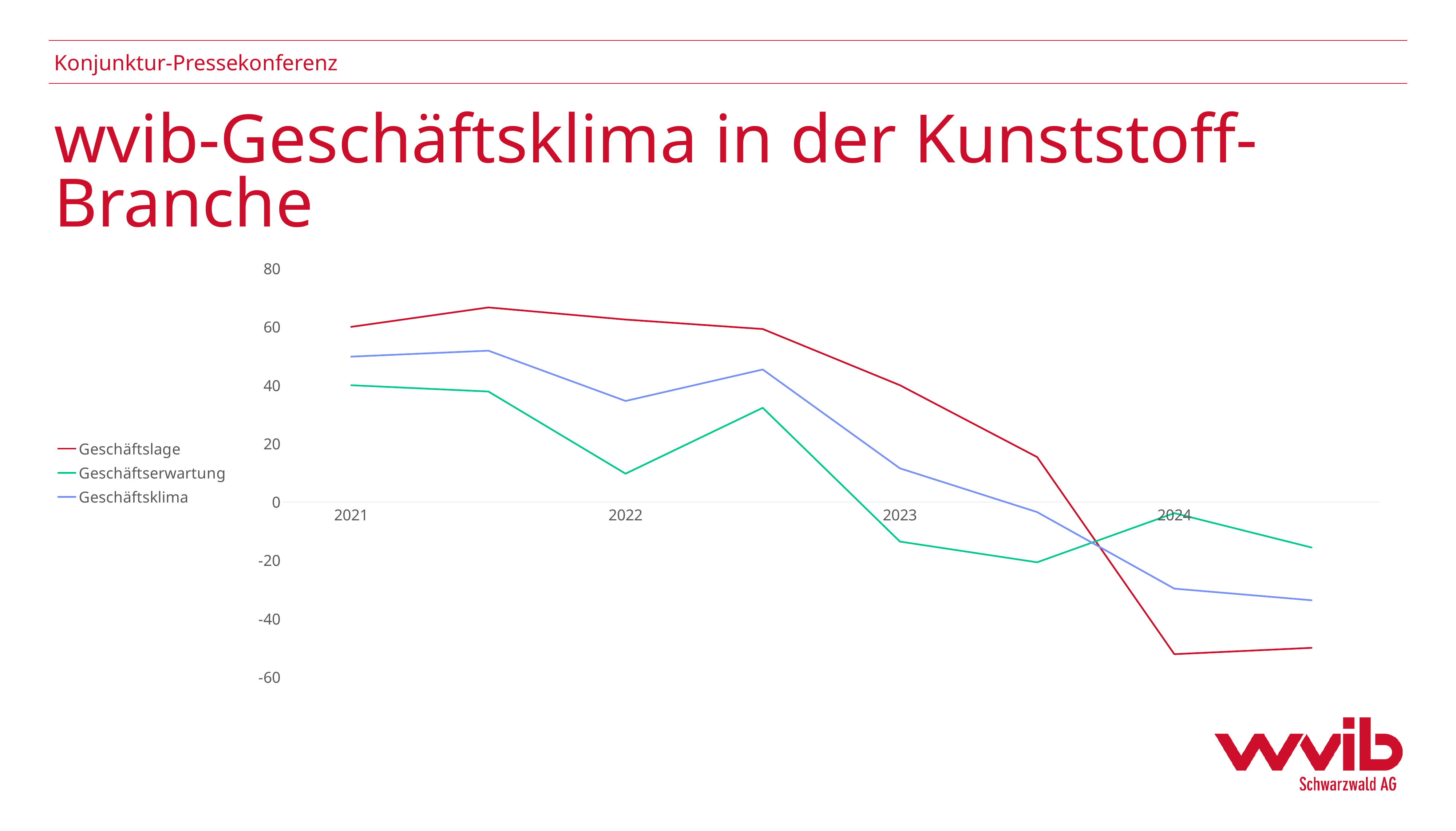
Is the value for Geschäftslage at 2024 greater or less than -40? less Which series has the lowest value at 2024? Geschäftslage Is the value for Geschäftserwartung at 2022 greater or less than 20? less Which series are listed in the legend? Geschäftslage, Geschäftserwartung, Geschäftsklima How many series does the legend list? 3 Is the value for Geschäftserwartung at 2023 greater or less than 0? less Does the Geschäftslage line rise or fall from 2021 to 2024? fall How many year labels are shown on the x axis? 4 What kind of chart is shown on the slide? line chart At 2021, which is larger: Geschäftslage or Geschäftserwartung? Geschäftslage